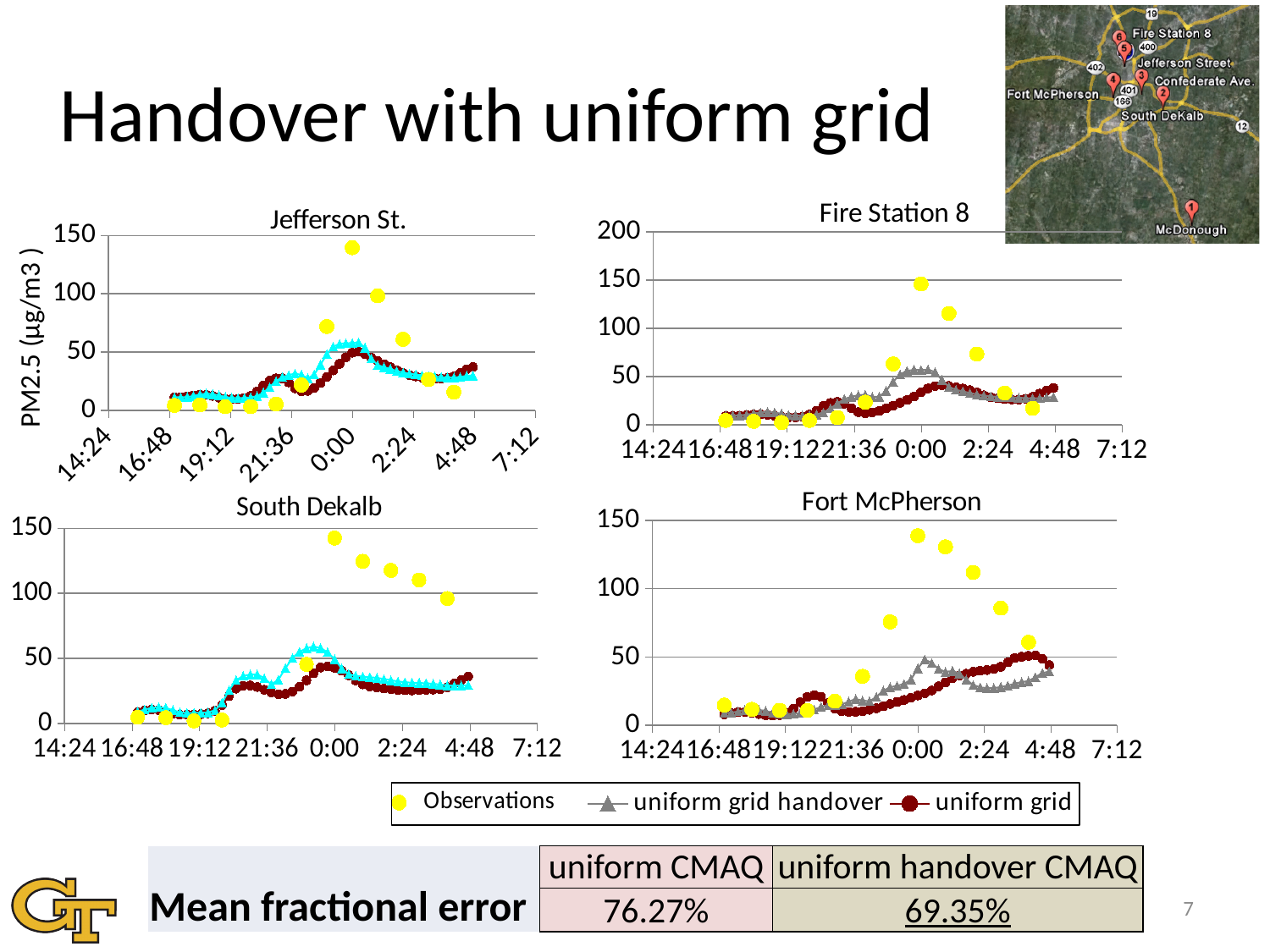
How many line charts are shown on the slide? 4 How many series does the shared legend list for the charts? 3 In the South Dekalb chart, is the highest observation value greater or less than 100? greater In the Jefferson St. chart, is the peak of the uniform grid series greater or less than 100? less What is the y-axis label on the Jefferson St. chart? PM2.5 (µg/m3 ) In the Fort McPherson chart, which series reaches the higher peak value, Observations or uniform grid? Observations What kind of chart is the Jefferson St. chart? line chart In the Fort McPherson chart, is the highest observation value greater or less than 100? greater Which series is shown with yellow circle markers in the legend? Observations In the South Dekalb chart, do the observation values rise or fall between 0:00 and 4:48? fall